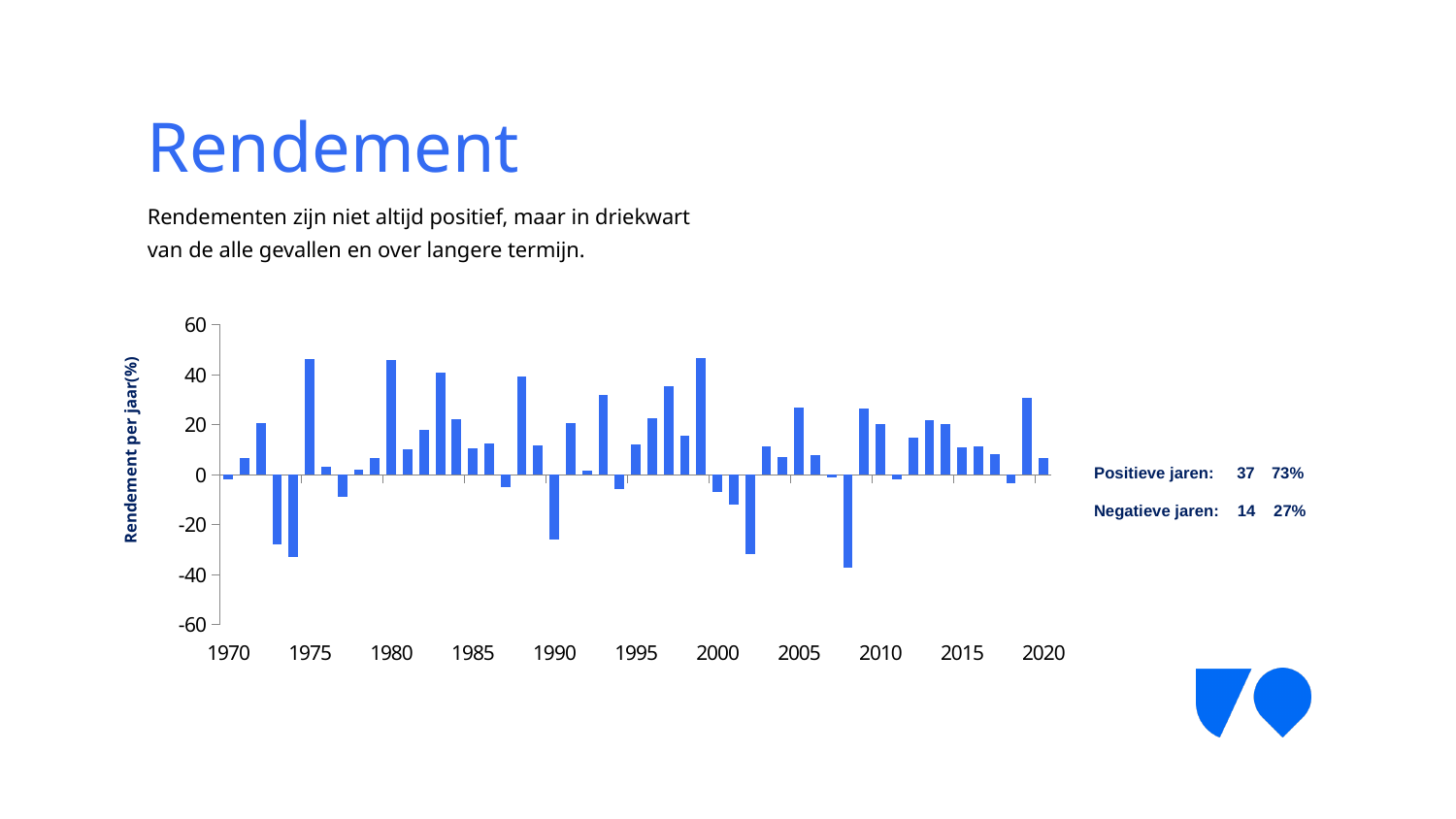
Is the value for 1985 greater or less than 20? less What kind of chart is shown on the slide? bar chart Which year has the larger value, 1990 or 2000? 2000 Is the value for 2000 greater or less than 0? less Is the value for 1975 greater or less than 40? greater According to the slide, how many positive years are there and what percentage is that? 37, 73% Which year has the larger value, 1975 or 1985? 1975 What is the label of the vertical axis? Rendement per jaar(%) Which year has the larger value, 2005 or 2015? 2005